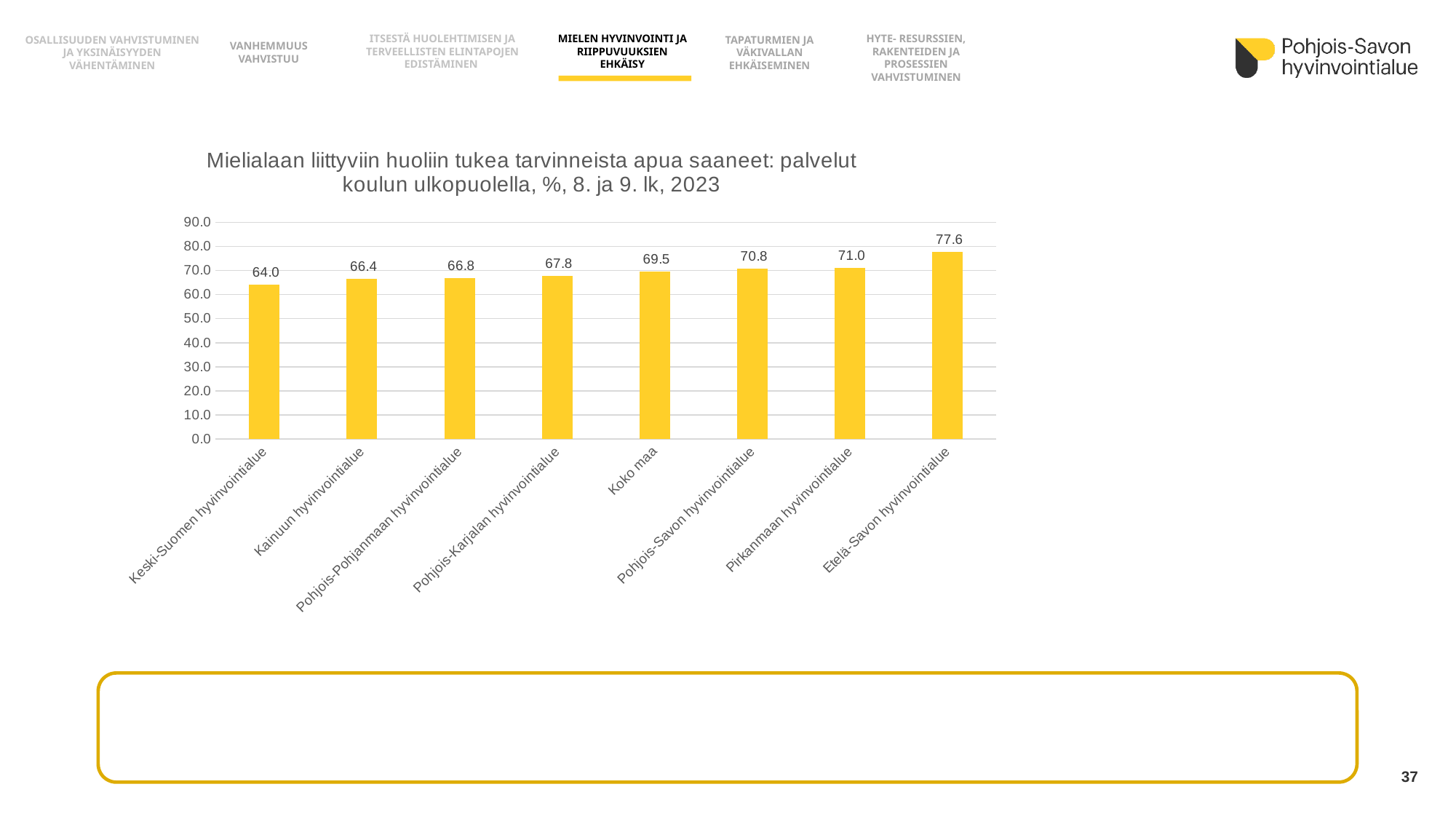
Do the values rise or fall from left to right along the x axis? rise What is the value for Pohjois-Savon hyvinvointialue? 70.8 How many categories are shown on the x axis? 8 Which category has the lowest value? Keski-Suomen hyvinvointialue What is the value for Koko maa? 69.5 Which is larger, the value for Pirkanmaan hyvinvointialue or the value for Pohjois-Karjalan hyvinvointialue? Pirkanmaan hyvinvointialue What is the difference between the values for Pohjois-Savon hyvinvointialue and Koko maa? 1.3 Which category has the highest value? Etelä-Savon hyvinvointialue What is the value for Kainuun hyvinvointialue? 66.4 What is the difference between the values for Etelä-Savon hyvinvointialue and Keski-Suomen hyvinvointialue? 13.6 What kind of chart is shown on the slide? bar chart Is the value for Pohjois-Pohjanmaan hyvinvointialue greater or less than 60.0? greater